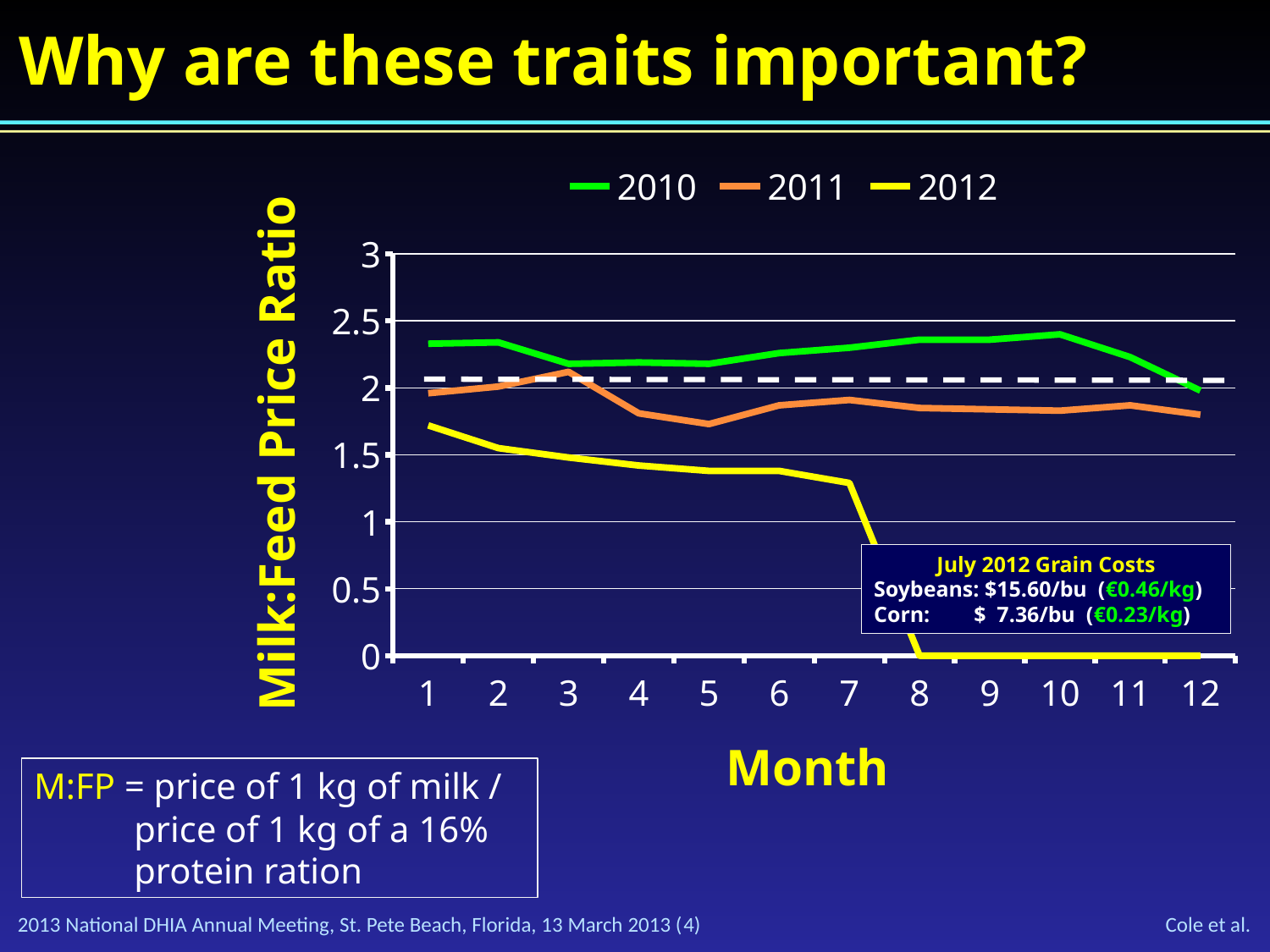
Which colour is used for the 2012 series? yellow How many months are shown along the x axis? 12 Which series has the lowest value in month 1? 2012 Which series has the highest value in month 4? 2010 What is the title of the y axis? Milk:Feed Price Ratio Is the value for 2010 in month 1 greater or less than 2? greater Does the 2012 series rise or fall from month 1 to month 12? fall Is the value for 2011 in month 5 greater or less than 2? less Which is larger in month 6, the value for 2010 or the value for 2011? 2010 Is the value for 2012 in month 7 greater or less than 1.5? less What kind of chart is shown on the slide? line chart How many series does the legend list? 3